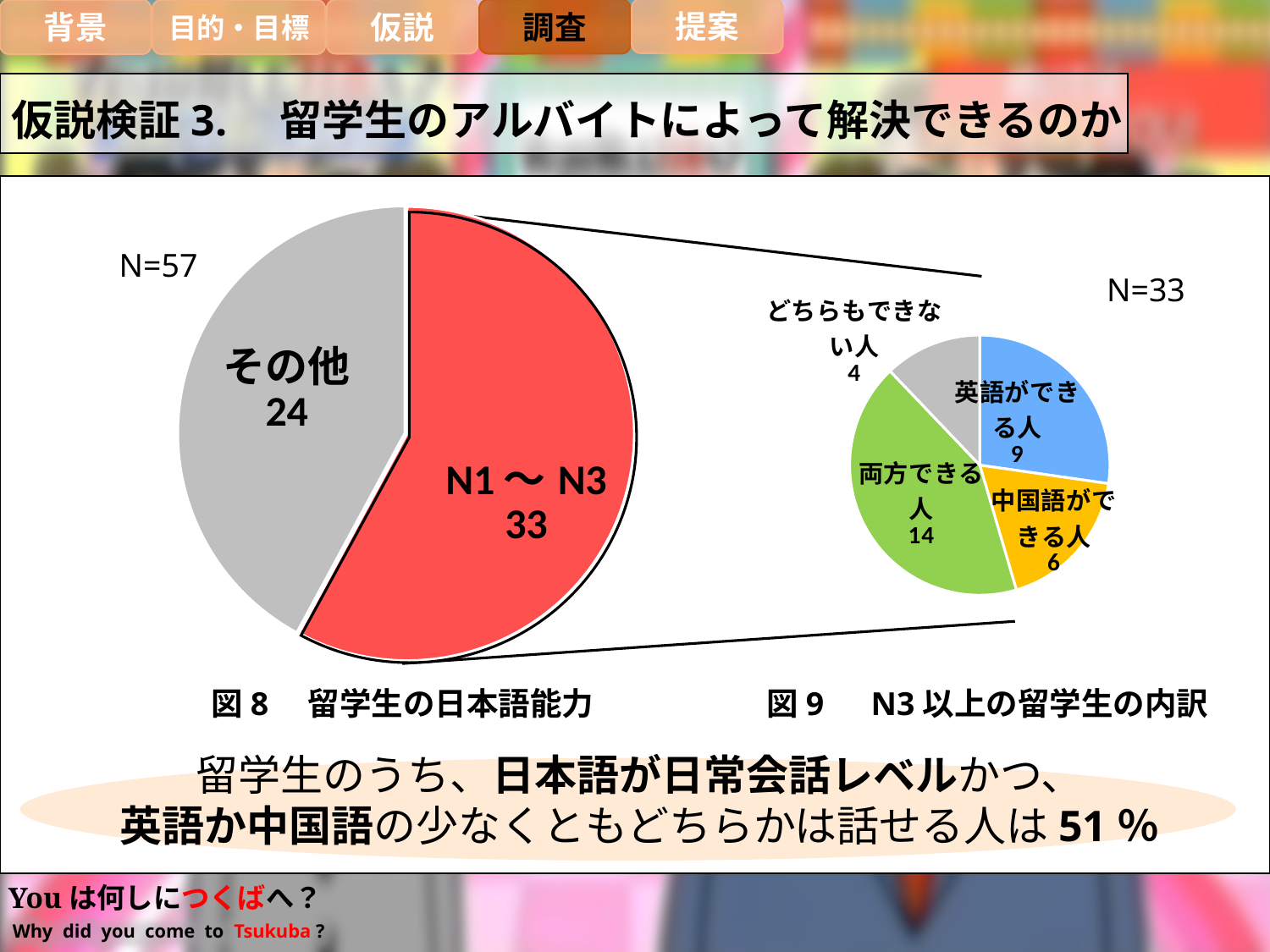
In the chart 図9 N3以上の留学生の内訳, what is the value for 両方できる人? 14 In the chart 図8 留学生の日本語能力, what is the value for その他? 24 What kind of chart is 図8 留学生の日本語能力? Pie chart In the chart 図9 N3以上の留学生の内訳, what is the value for 中国語ができる人? 6 In the chart 図8 留学生の日本語能力, which slice is larger, N1～N3 or その他? N1～N3 In the chart 図9 N3以上の留学生の内訳, what is the difference between 英語ができる人 and 中国語ができる人? 3 In the chart 図8 留学生の日本語能力, what is the difference between the N1～N3 value and the その他 value? 9 In the chart 図9 N3以上の留学生の内訳, which category has the lowest value? どちらもできない人 In the chart 図8 留学生の日本語能力, how many slices does the pie have? 2 In the chart 図8 留学生の日本語能力, what is the value for N1～N3? 33 In the chart 図9 N3以上の留学生の内訳, which category has the highest value? 両方できる人 In the chart 図9 N3以上の留学生の内訳, how many categories are shown? 4